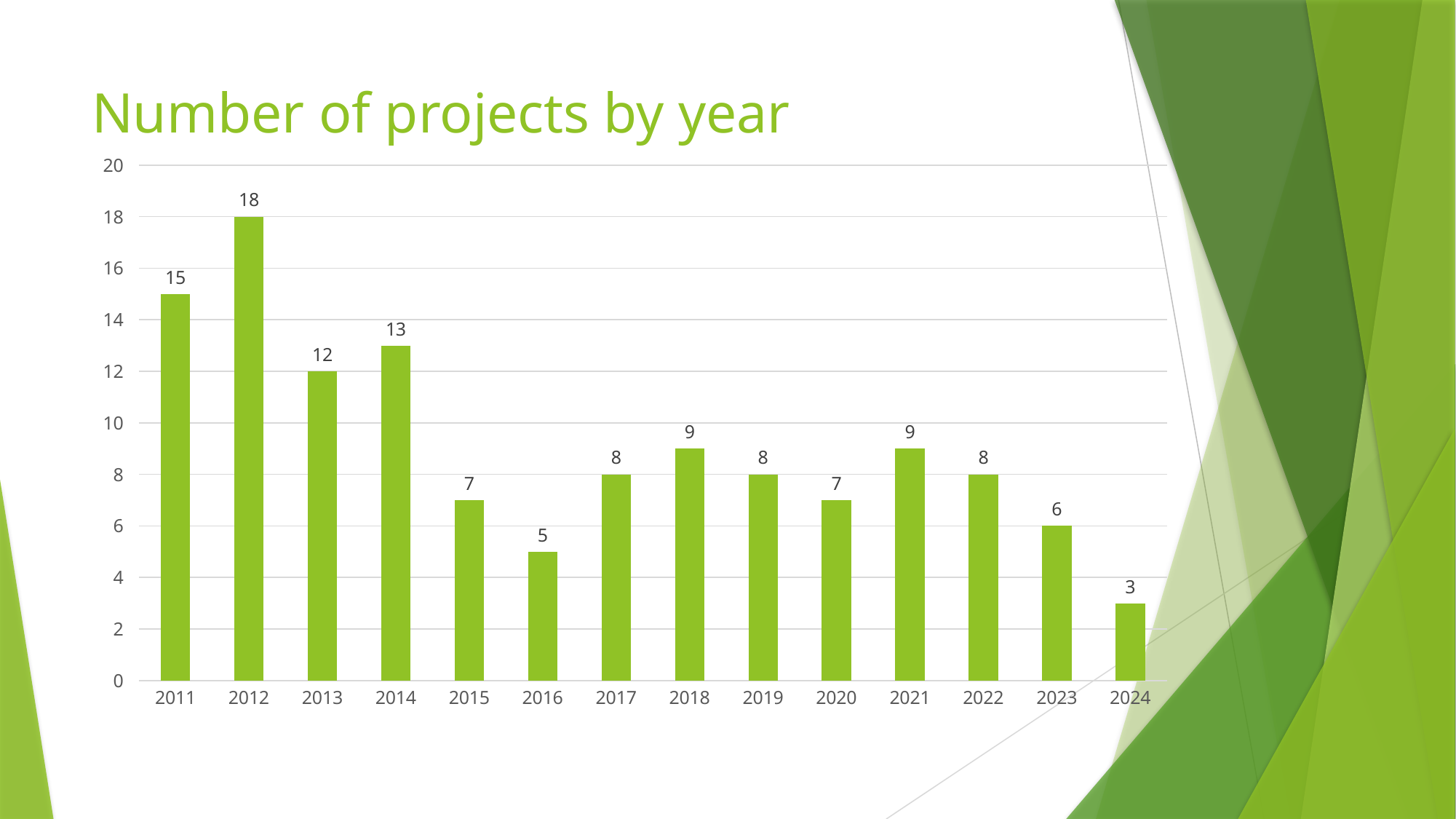
What is the number of projects in 2016? 5 What is the difference between the number of projects in 2012 and 2024? 15 What is the difference between the number of projects in 2011 and 2013? 3 Which year has the lowest number of projects? 2024 Which year has the highest number of projects? 2012 Is the value for 2018 greater or less than 10? less What is the number of projects in 2012? 18 Which year has more projects, 2014 or 2015? 2014 What is the number of projects in 2024? 3 What is the title of the chart? Number of projects by year How many years are shown on the x axis? 14 What kind of chart is shown on the slide? Bar chart